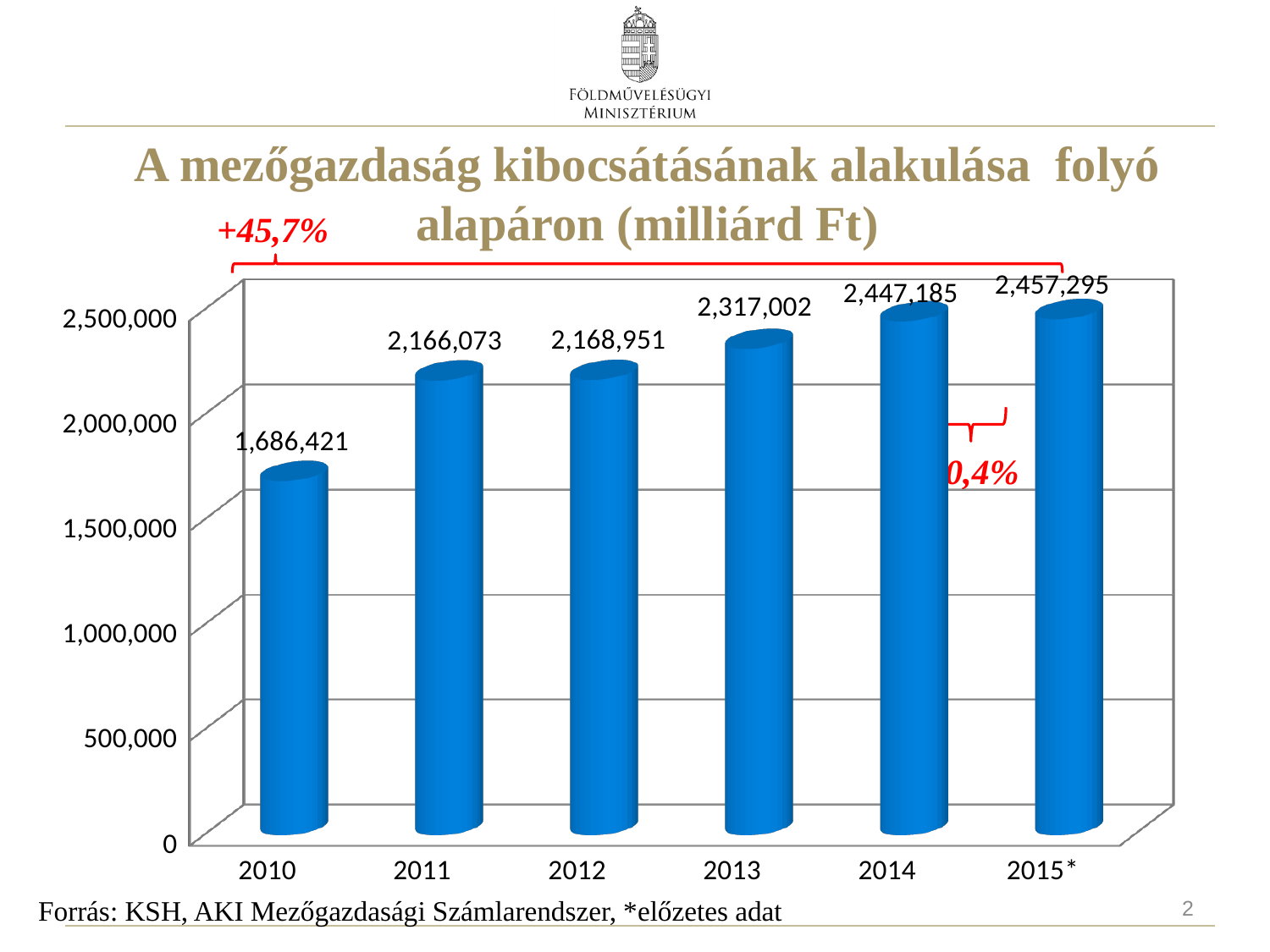
What kind of chart is shown on the slide? bar chart What percentage change is annotated in red above the chart between 2010 and 2015*? +45,7% What is the difference between the values for 2011 and 2010? 479,652 What is the value for 2013? 2,317,002 Which year has the lowest value? 2010 Which is larger, the value for 2013 or the value for 2012? 2013 Is the value for 2010 greater or less than 2,000,000? less What is the value for 2015*? 2,457,295 Which year has the highest value? 2015* What is the value for 2010? 1,686,421 How many years are shown on the x axis? 6 What is the difference between the values for 2015* and 2014? 10,110